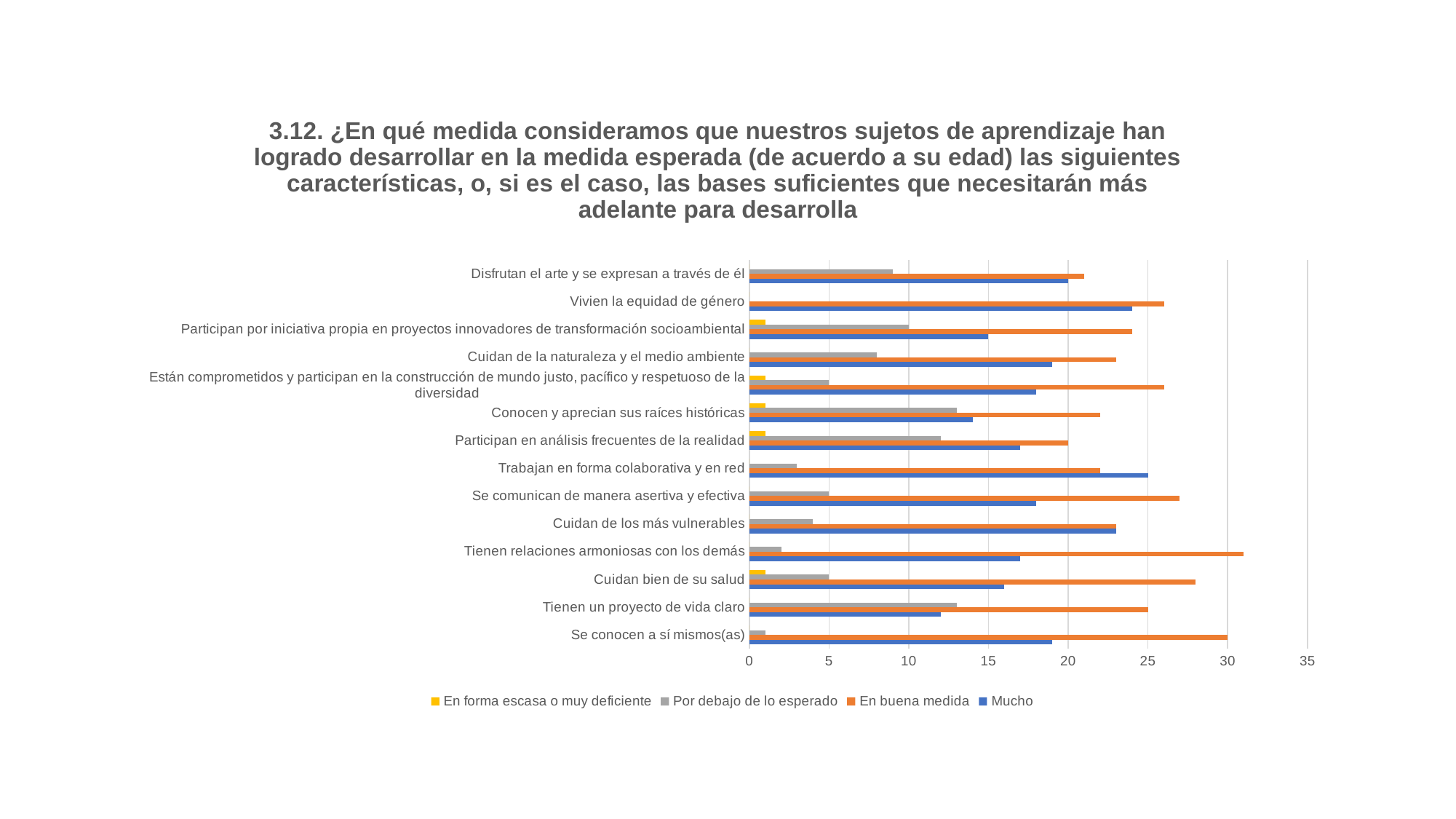
Is the 'En buena medida' value for 'Se conocen a sí mismos(as)' greater or less than 25? greater How many series does the legend list? 4 What kind of chart is shown on the slide? bar chart Which category has the highest value for the 'En buena medida' series? Tienen relaciones armoniosas con los demás Which series is shown in orange in the legend? En buena medida Is the 'Mucho' value for 'Tienen un proyecto de vida claro' greater or less than 15? less For 'Cuidan bien de su salud', which is larger: the 'En buena medida' value or the 'Mucho' value? En buena medida Is the 'Por debajo de lo esperado' value for 'Tienen relaciones armoniosas con los demás' greater or less than 5? less What is the 'Mucho' value for 'Trabajan en forma colaborativa y en red'? 25 For 'Trabajan en forma colaborativa y en red', which is larger: the 'Mucho' value or the 'Por debajo de lo esperado' value? Mucho What is the 'En buena medida' value for 'Se conocen a sí mismos(as)'? 30 How many categories are listed on the vertical axis of the chart? 14